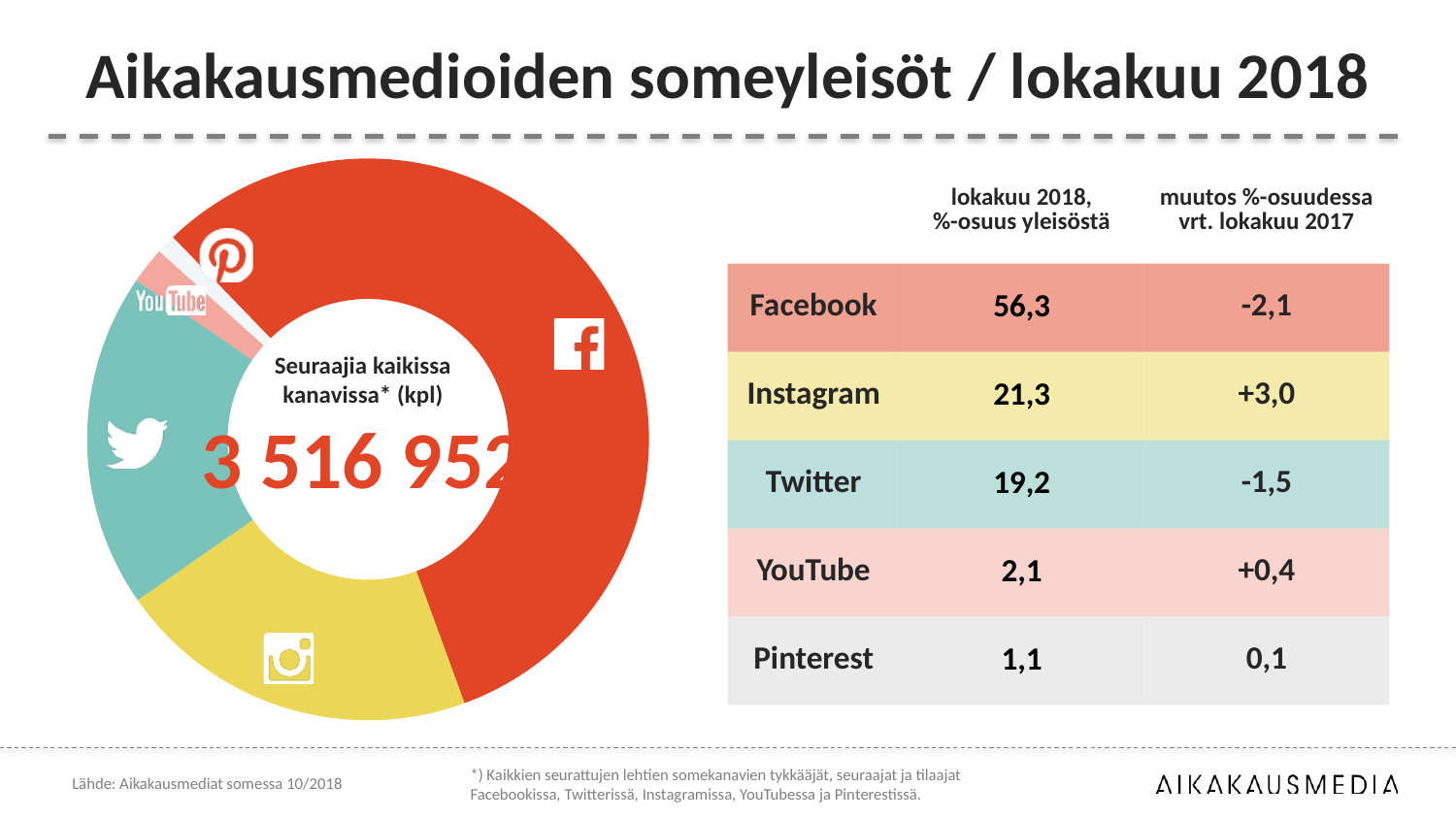
What is the title of the slide? Aikakausmedioiden someyleisöt / lokakuu 2018 What is the change in percentage share for Instagram compared with October 2017? +3,0 Which has a larger share of the audience, Instagram or Twitter? Instagram What is the change in percentage share for Facebook compared with October 2017? -2,1 What is Facebook's share of the audience in October 2018? 56,3 What is Twitter's share of the audience in October 2018? 19,2 How many social media channels (slices) does the donut chart show? 5 Which channel has the largest share of the audience in October 2018? Facebook Which channel has the smallest share of the audience in October 2018? Pinterest How many percentage points larger is Facebook's share than Instagram's share in October 2018? 35,0 What is the total number of followers across all channels shown in the centre of the donut chart? 3 516 952 What kind of chart is shown on the left of the slide? Pie (donut) chart